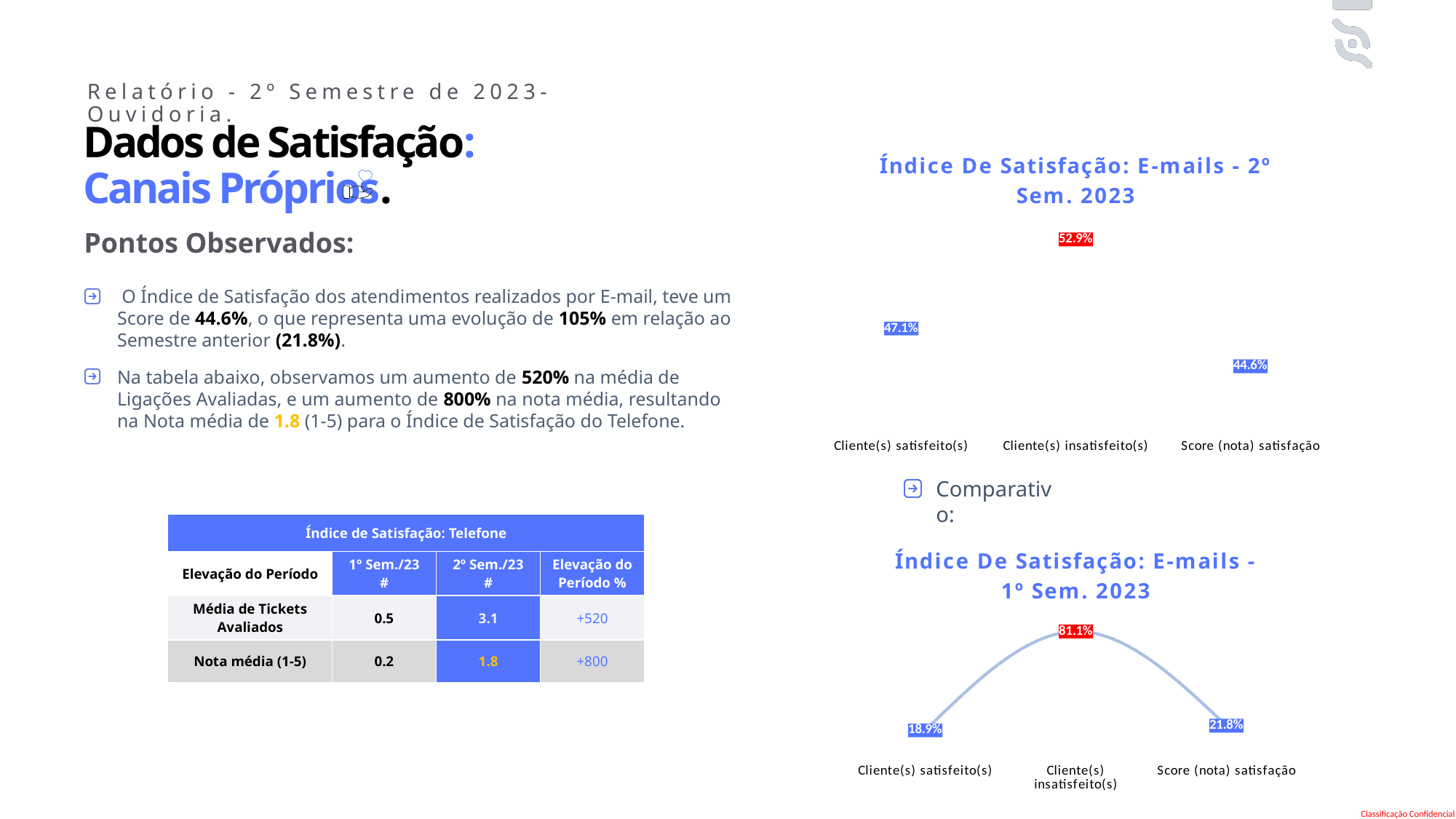
In the chart titled "Índice De Satisfação: E-mails - 1º Sem. 2023", what is the value for Score (nota) satisfação? 21.8% In the chart titled "Índice De Satisfação: E-mails - 1º Sem. 2023", what kind of chart is shown? Line chart Which is larger: Score (nota) satisfação in the 2º Sem. 2023 chart or Score (nota) satisfação in the 1º Sem. 2023 chart? 2º Sem. 2023 In the chart titled "Índice De Satisfação: E-mails - 1º Sem. 2023", which category has the lowest value? Cliente(s) satisfeito(s) In the chart titled "Índice De Satisfação: E-mails - 1º Sem. 2023", what is the value for Cliente(s) insatisfeito(s)? 81.1% In the chart titled "Índice De Satisfação: E-mails - 2º Sem. 2023", how many categories are shown on the x axis? 3 In the chart titled "Índice De Satisfação: E-mails - 2º Sem. 2023", what is the value for Cliente(s) insatisfeito(s)? 52.9% In the chart titled "Índice De Satisfação: E-mails - 2º Sem. 2023", what is the value for Score (nota) satisfação? 44.6% In the chart titled "Índice De Satisfação: E-mails - 2º Sem. 2023", which category has the highest value? Cliente(s) insatisfeito(s) In the chart titled "Índice De Satisfação: E-mails - 2º Sem. 2023", what is the difference between Cliente(s) insatisfeito(s) and Cliente(s) satisfeito(s)? 5.8% In the chart titled "Índice De Satisfação: E-mails - 2º Sem. 2023", what is the value for Cliente(s) satisfeito(s)? 47.1% In the chart titled "Índice De Satisfação: E-mails - 1º Sem. 2023", what is the value for Cliente(s) satisfeito(s)? 18.9%